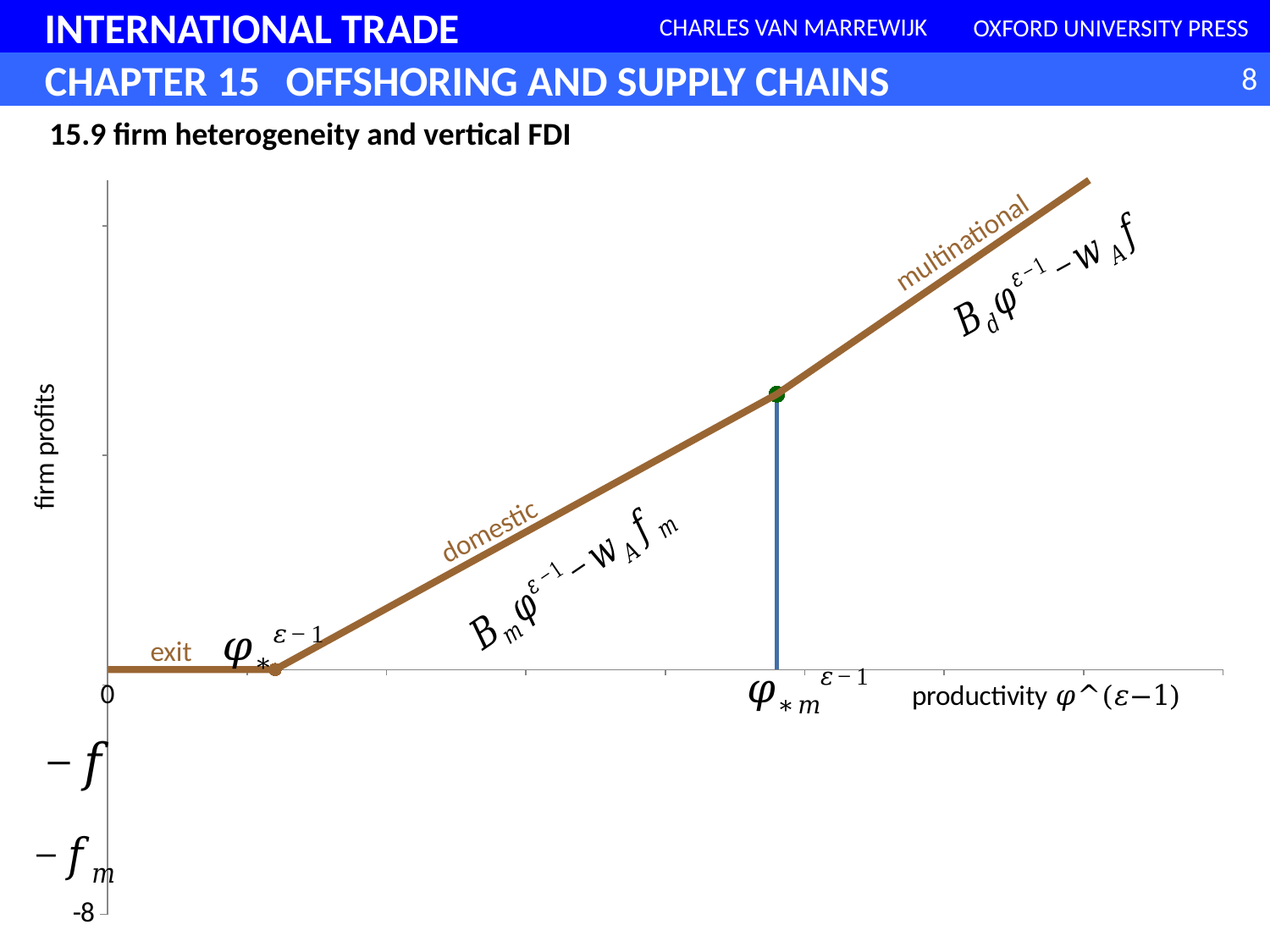
What is the label on the vertical axis of the chart? firm profits Which region of the chart is labelled at the far left, where the profit line is flat? exit Which region of the chart is labelled on the steepest, rightmost segment of the profit line? multinational What kind of chart is shown on the slide? line chart Is the profit line in the multinational region higher or lower than in the domestic region? higher Do firm profits rise or fall as productivity increases along the x axis to the right of the exit region? rise What value is printed at the origin of the horizontal axis? 0 How many labelled regions (exit, domestic, multinational) does the profit line pass through? 3 Which region lies between the exit region and the multinational region on the chart? domestic What is the lowest tick value printed on the vertical axis? -8 What is the label on the horizontal axis of the chart? productivity φ^(ε−1)